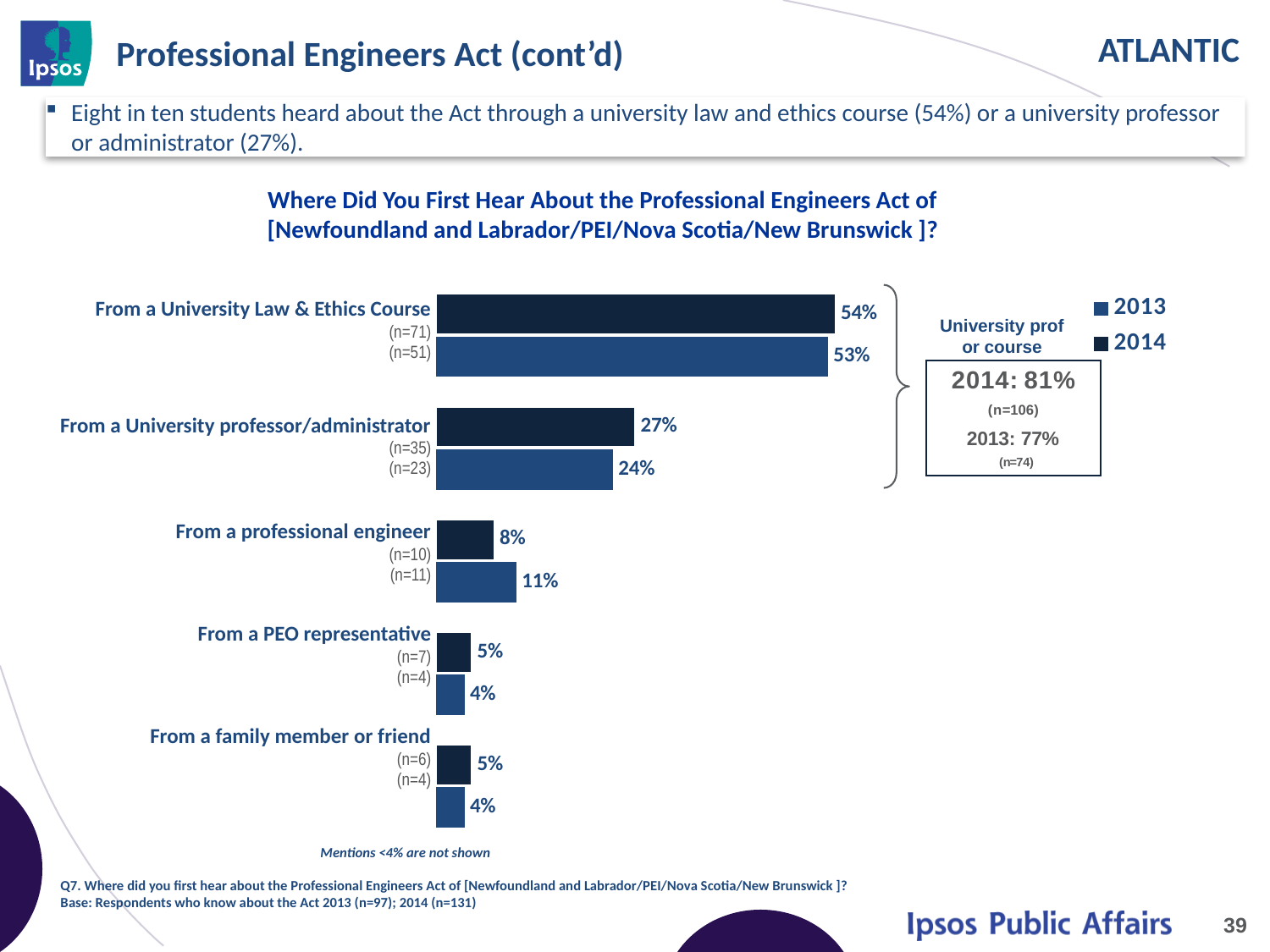
According to the callout box, what is the combined 2014 value for 'University prof or course'? 81% What are the two values shown for 'From a PEO representative'? 5% and 4% Which category has the highest values in the chart? From a University Law & Ethics Course What are the two entries in the chart legend? 2013 and 2014 What is the difference between the combined 2014 value (81%) and the combined 2013 value (77%) in the callout box? 4 percentage points How many series does the chart legend list? 2 What are the two values shown for 'From a University Law & Ethics Course'? 54% and 53% How many source categories are shown in the chart? 5 What type of chart is shown on the slide? Bar chart What are the two values shown for 'From a professional engineer'? 8% and 11% Which is larger, the combined 'University prof or course' value for 2014 or for 2013? 2014 According to the callout box, what is the combined 2013 value for 'University prof or course'? 77%